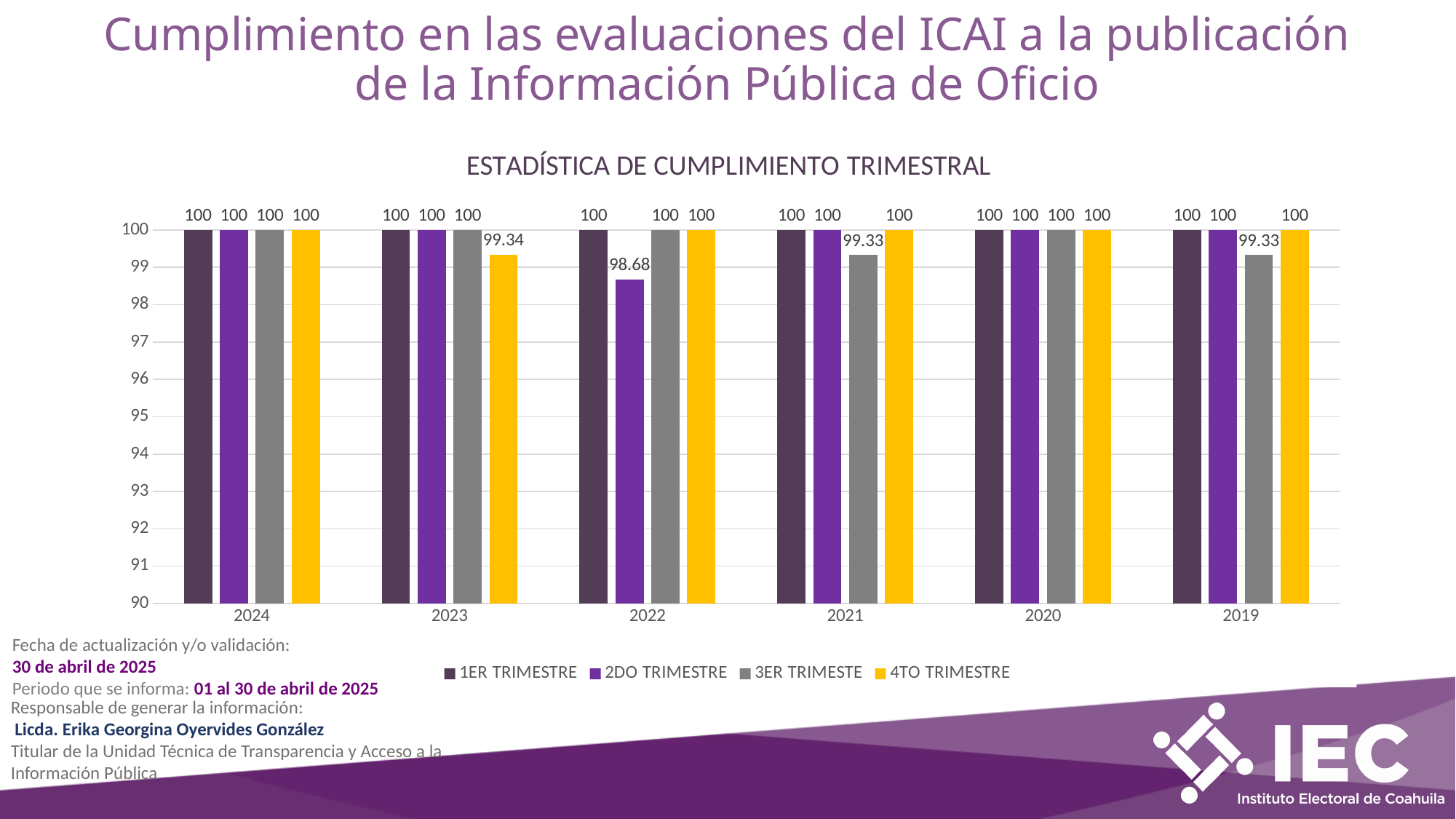
How many series does the legend list? 4 What is the difference between the 1ER TRIMESTRE and 3ER TRIMESTE values in 2021? 0.67 What kind of chart is shown on the slide? Bar chart What is the value for 1ER TRIMESTRE in 2019? 100 What is the title of the chart? ESTADÍSTICA DE CUMPLIMIENTO TRIMESTRAL What is the difference between the 1ER TRIMESTRE and 2DO TRIMESTRE values in 2022? 1.32 What is the value for 2DO TRIMESTRE in 2022? 98.68 Which is larger: the 4TO TRIMESTRE value in 2023 or the 2DO TRIMESTRE value in 2022? 4TO TRIMESTRE in 2023 What is the value for 4TO TRIMESTRE in 2023? 99.34 Which year and series has the lowest value in the chart? 2DO TRIMESTRE in 2022 How many years are shown on the x axis? 6 What is the value for 3ER TRIMESTE in 2021? 99.33